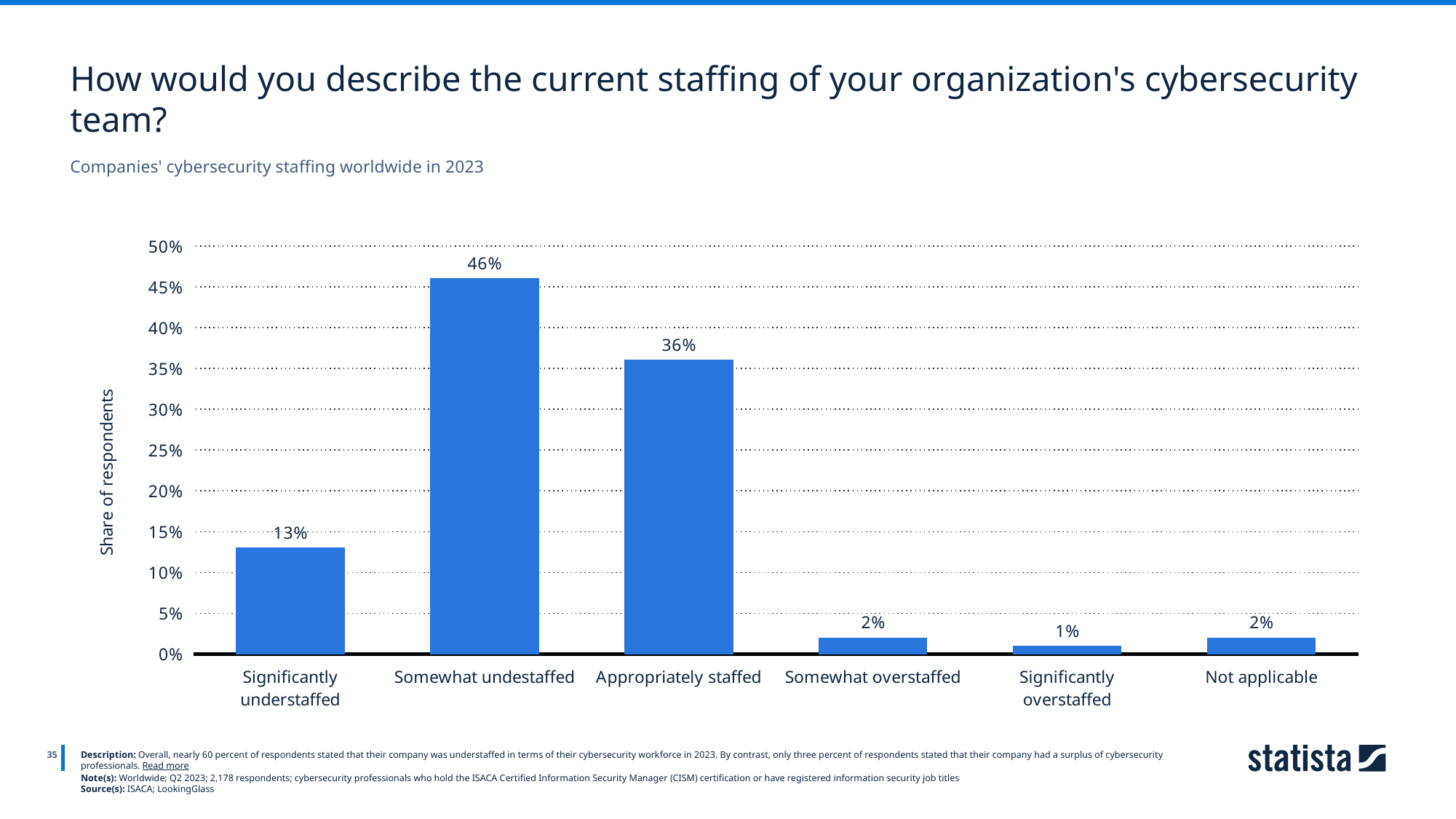
What share of respondents said their cybersecurity team is significantly understaffed? 13% What share of respondents said their cybersecurity team is appropriately staffed? 36% What share of respondents said their cybersecurity team is significantly overstaffed? 1% What kind of chart is shown on the slide? Bar chart Is the value for appropriately staffed greater or less than 40%? less What is the label of the y axis? Share of respondents What share of respondents said their cybersecurity team is somewhat understaffed? 46% What is the difference between the share for somewhat understaffed and the share for appropriately staffed? 10% How many staffing categories are shown on the x axis? 6 Which is larger: the share for significantly understaffed or the share for somewhat overstaffed? Significantly understaffed Which staffing category has the lowest share of respondents? Significantly overstaffed Which staffing category has the highest share of respondents? Somewhat understaffed